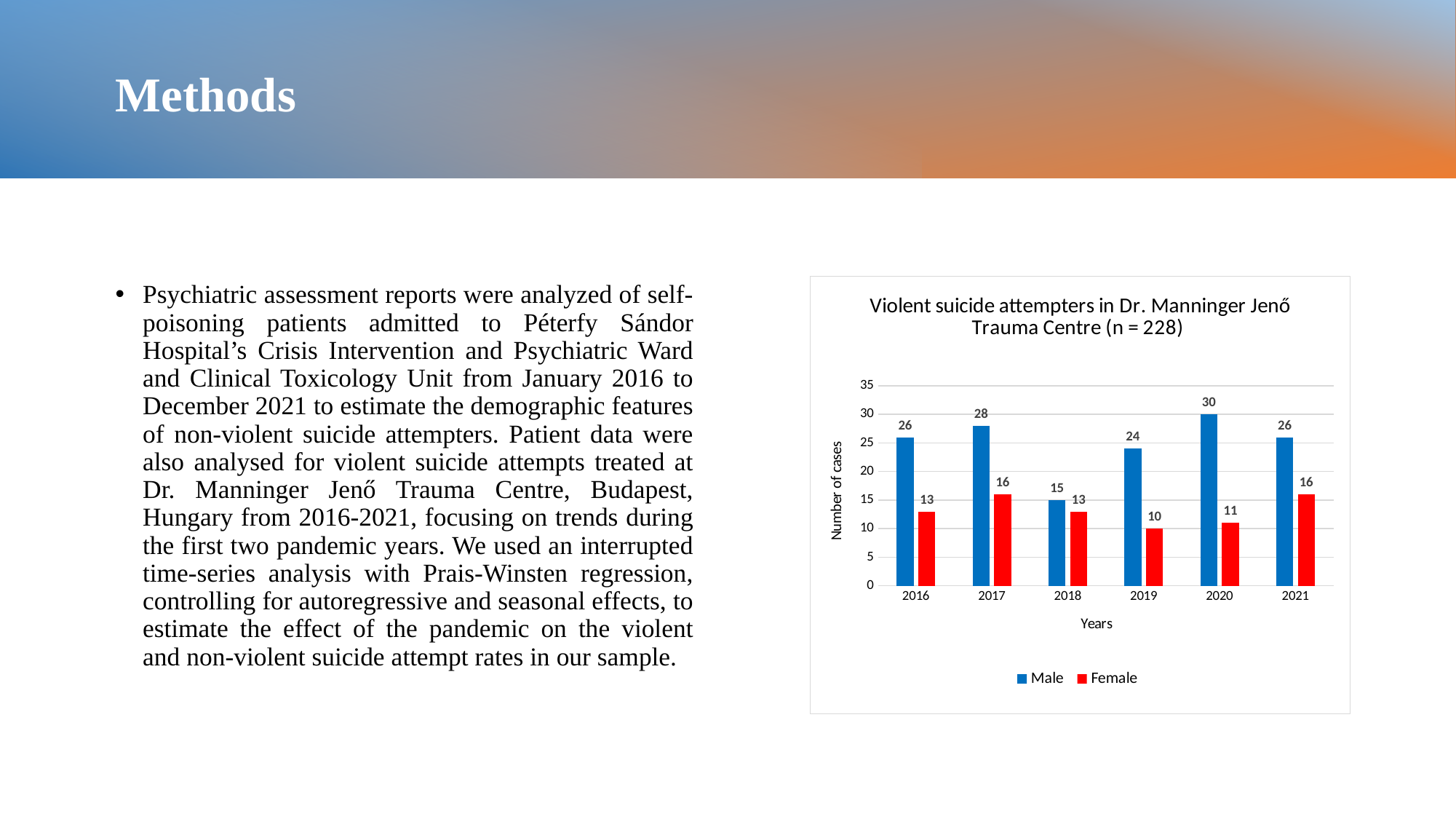
What kind of chart is shown? bar chart Which is larger in 2018, the Male value or the Female value? Male Which year has the lowest Female value? 2019 What is the title of the chart? Violent suicide attempters in Dr. Manninger Jenő Trauma Centre (n = 228) How many years are shown on the x axis? 6 What is the Male value for 2020? 30 Which year has the highest Male value? 2020 How many series does the legend list? 2 What is the Male value for 2018? 15 What is the Female value for 2019? 10 What is the difference between the Male and Female values in 2020? 19 What is the total of the Male and Female values for 2017? 44